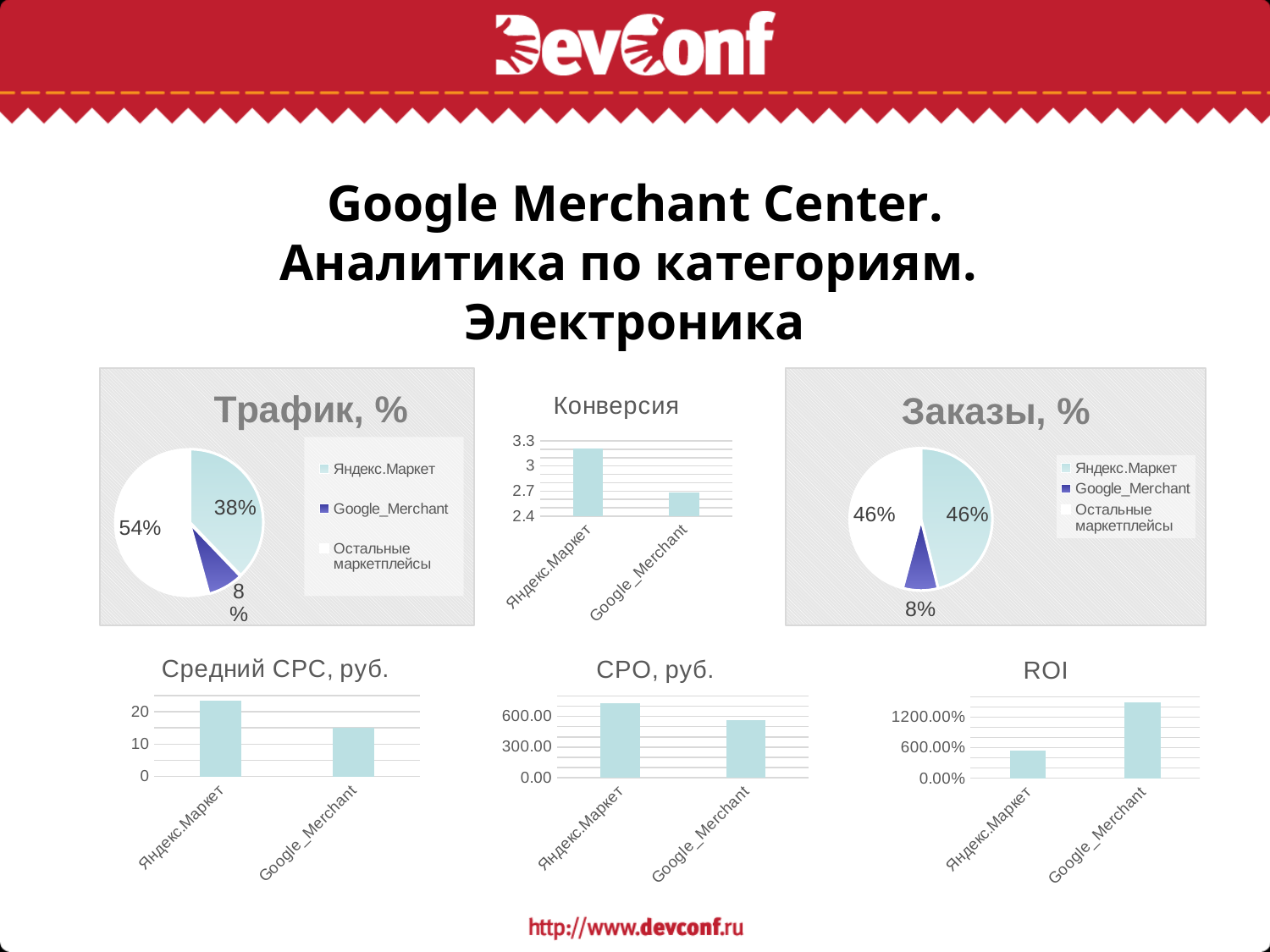
In the 'Трафик, %' pie chart, what share does Яндекс.Маркет have? 38% In the 'Конверсия' chart, is the value for Яндекс.Маркет greater or less than 3? greater In the 'Конверсия' chart, which has the higher value, Яндекс.Маркет or Google_Merchant? Яндекс.Маркет In the 'Заказы, %' pie chart, what is the share for Google_Merchant? 8% In the 'Заказы, %' pie chart, which category has the smallest share? Google_Merchant What kind of chart is the 'CPO, руб.' chart? bar chart In the 'Средний CPC, руб.' chart, is the value for Google_Merchant greater or less than 20? less In the 'ROI' chart, which has the higher value, Яндекс.Маркет or Google_Merchant? Google_Merchant How many entries does the legend of the 'Трафик, %' chart list? 3 In the 'Трафик, %' pie chart, what is the difference between the shares of Остальные маркетплейсы and Яндекс.Маркет? 16% In the 'CPO, руб.' chart, is the value for Яндекс.Маркет greater or less than 600.00? greater In the 'Трафик, %' pie chart, which category has the largest share? Остальные маркетплейсы